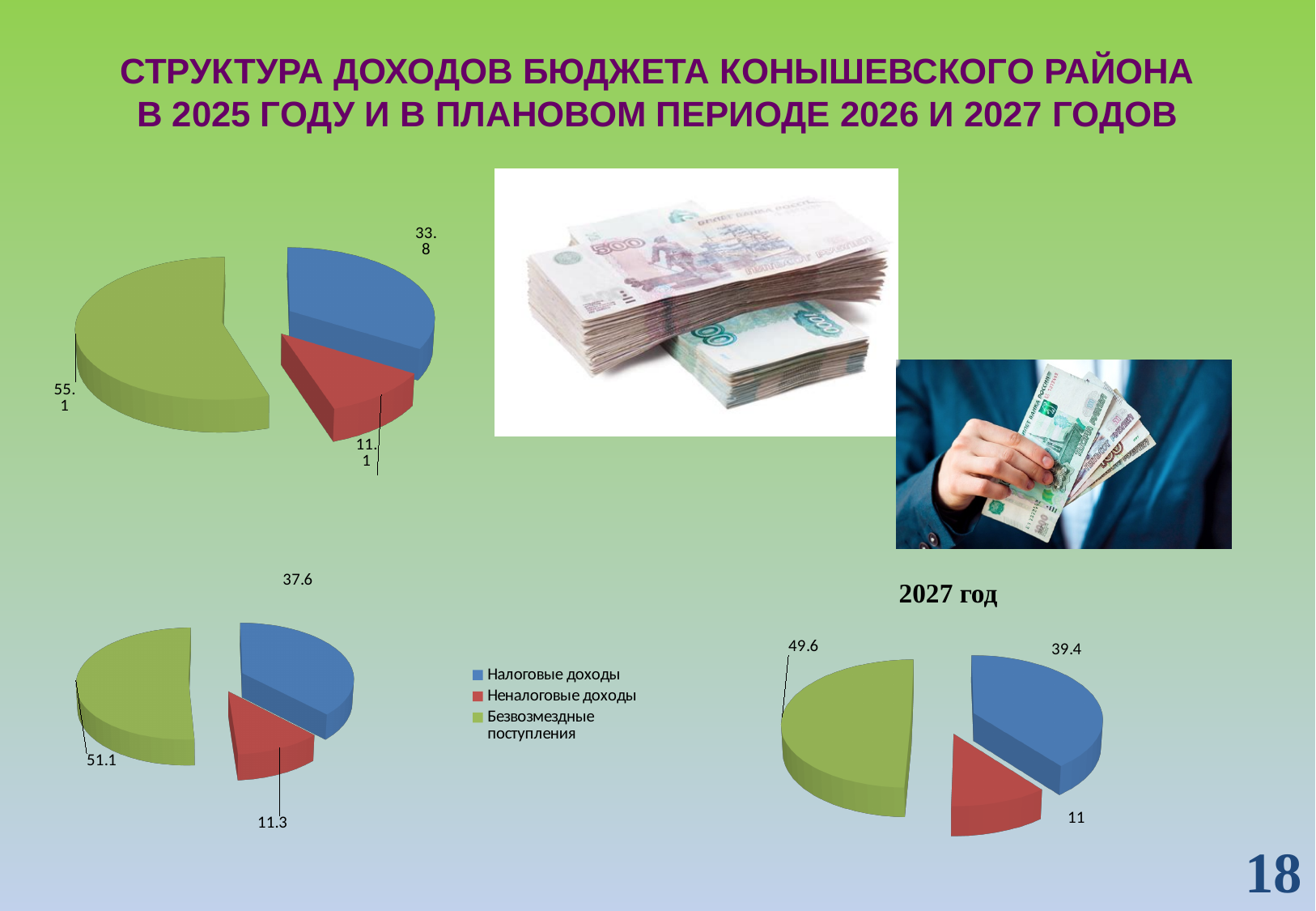
In the bottom-left pie chart, what is the difference between the Безвозмездные поступления slice and the Налоговые доходы slice? 13.5 In the top-left pie chart, what is the value of the Безвозмездные поступления slice? 55.1 In the pie chart titled 2027 год, what is the value of the Налоговые доходы slice? 39.4 In the top-left pie chart, what is the value of the Налоговые доходы slice? 33.8 What type of chart is used on this slide? Pie chart In the top-left pie chart, which category has the smallest slice? Неналоговые доходы How many categories does the legend list? 3 In the pie chart titled 2027 год, what is the value of the Неналоговые доходы slice? 11 In the bottom-left pie chart, which category has the largest slice? Безвозмездные поступления In the pie chart titled 2027 год, which is larger: Налоговые доходы or Безвозмездные поступления? Безвозмездные поступления How many pie charts are shown on the slide? 3 In the bottom-left pie chart, what is the value of the Неналоговые доходы slice? 11.3